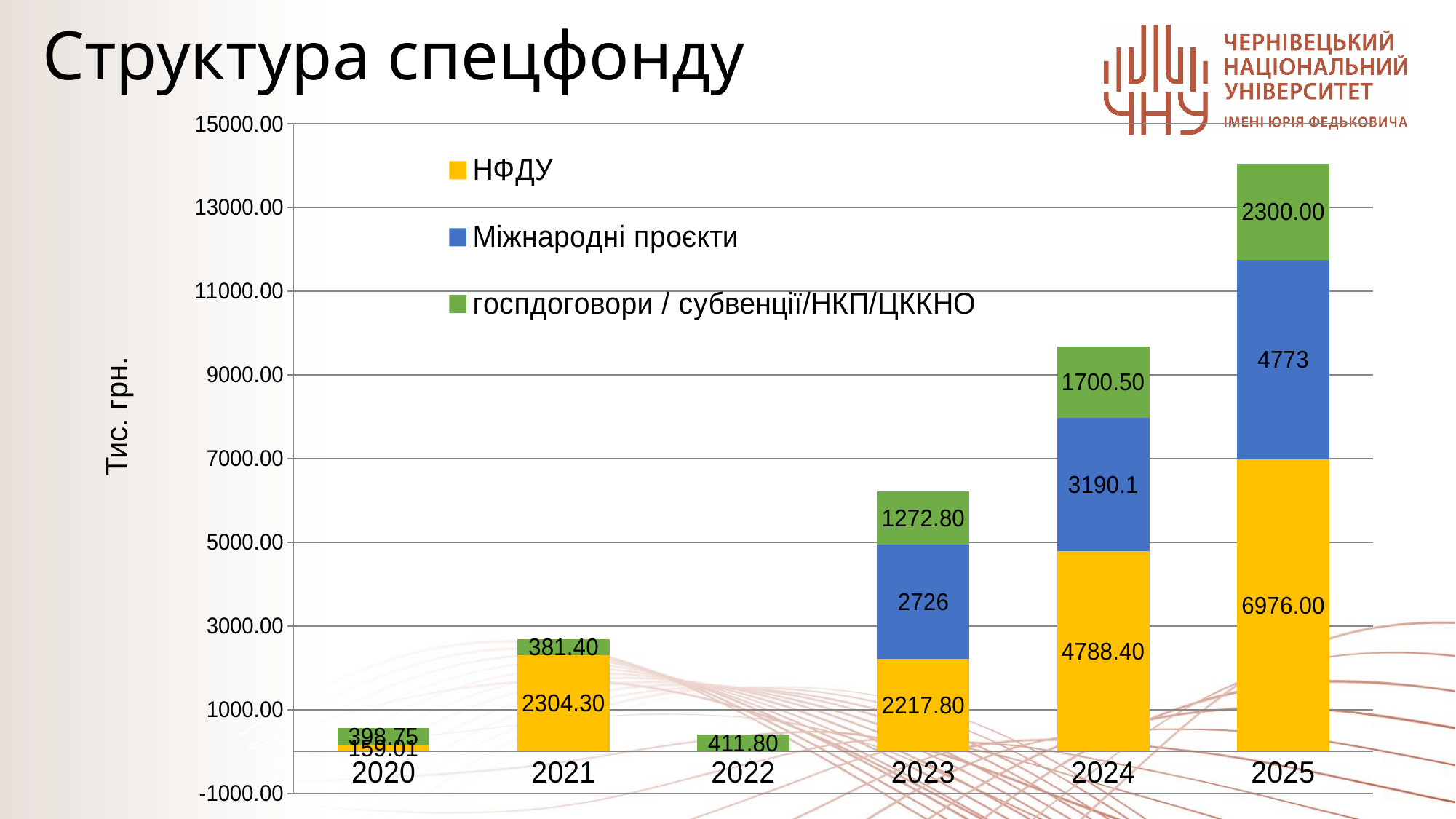
What is the value of Міжнародні проєкти for 2024? 3190.1 What is the value of НФДУ for 2021? 2304.30 Which year has the highest total stacked bar? 2025 How many series does the legend list? 3 What is the total of the stacked bar for 2024? 9679.00 Which is larger: Міжнародні проєкти in 2023 or in 2025? 2025 What is the value of госпдоговори / субвенції/НКП/ЦККНО for 2023? 1272.80 What type of chart is shown on the slide? Stacked bar chart What is the y-axis label of the chart? Тис. грн. How many years are shown on the x axis? 6 What is the difference between the НФДУ values for 2025 and 2024? 2187.60 What is the value of НФДУ for 2025? 6976.00